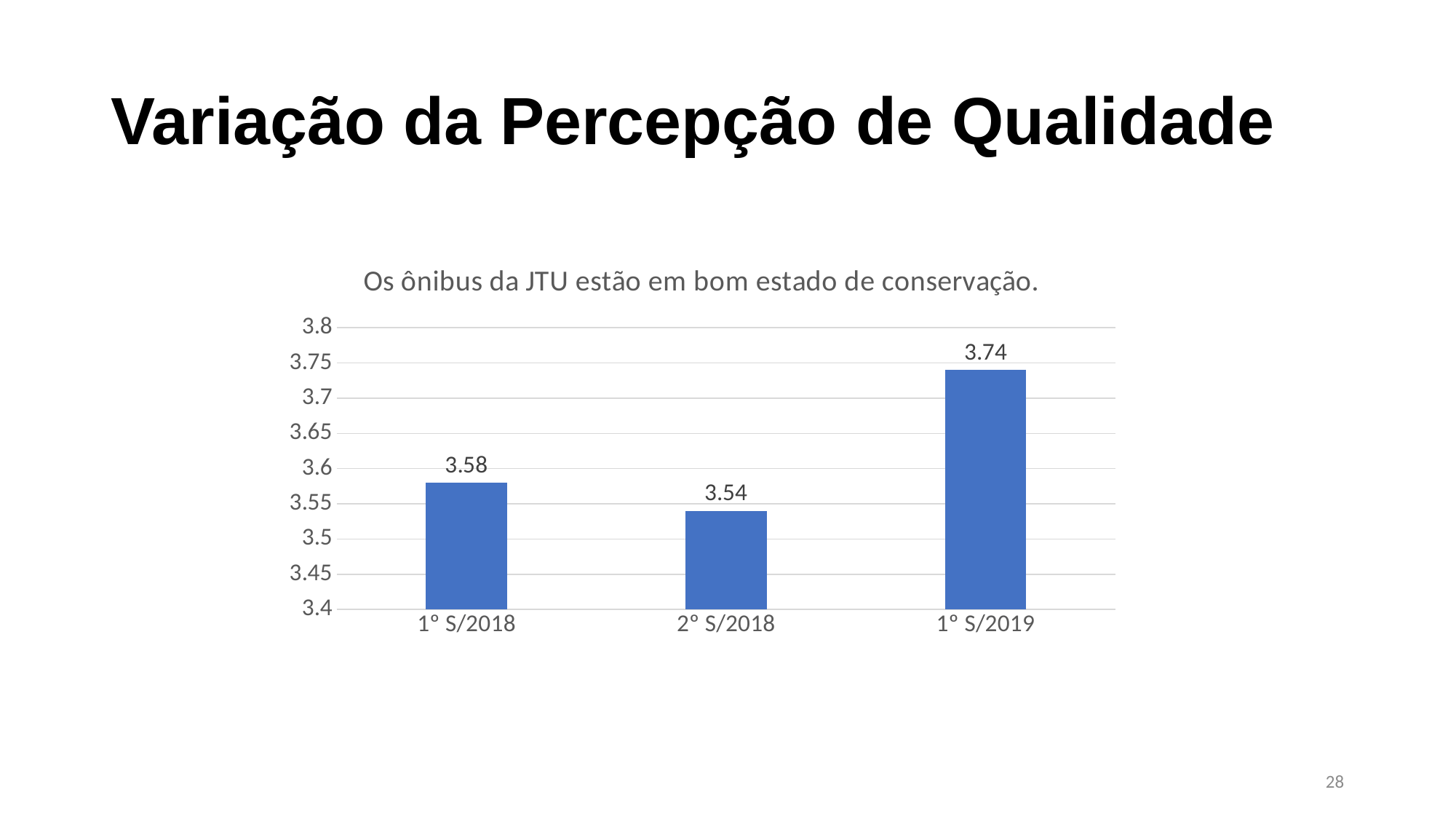
What kind of chart is shown on the slide? bar chart Which category has the lowest value? 2° S/2018 What is the title of the chart? Os ônibus da JTU estão em bom estado de conservação. How many categories are shown on the x axis? 3 What is the value for 2° S/2018? 3.54 What is the difference between the values for 1° S/2019 and 2° S/2018? 0.2 What is the difference between the values for 1° S/2018 and 2° S/2018? 0.04 Which is larger, the value for 1° S/2018 or the value for 2° S/2018? 1° S/2018 What is the value for 1° S/2019? 3.74 Is the value for 1° S/2019 greater or less than 3.7? greater Which category has the highest value? 1° S/2019 What is the value for 1° S/2018? 3.58